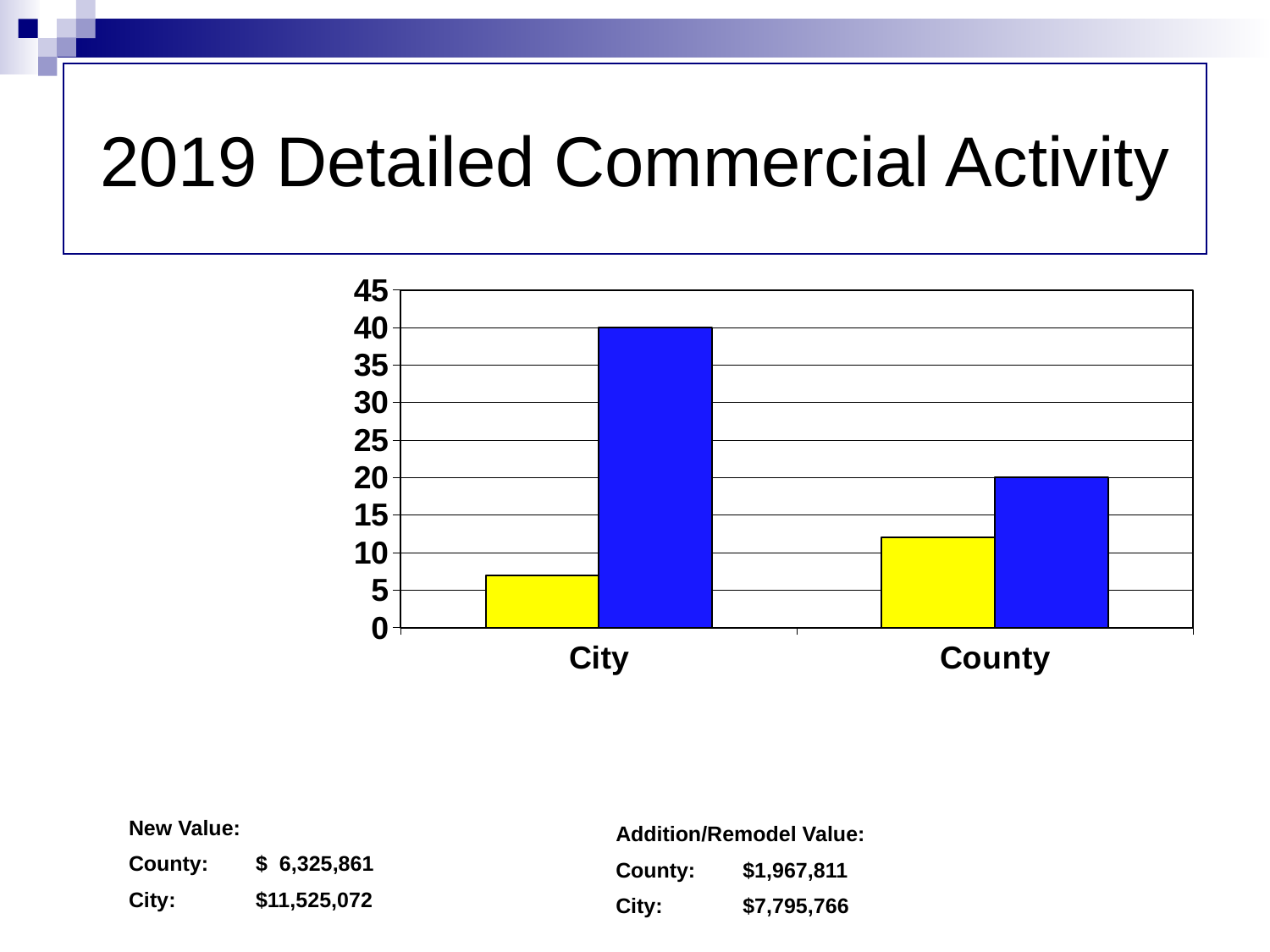
What is the difference between the blue bar for City and the blue bar for County? 20 Is the yellow bar for County greater or less than 10? greater Which bar in the chart is the shortest? the yellow bar for City What kind of chart is shown on the slide? bar chart Which bar in the chart is the tallest? the blue bar for City Which is larger, the yellow bar for City or the yellow bar for County? the yellow bar for County Is the yellow bar for City greater or less than 10? less What is the value of the blue bar for City? 40 What is the highest value shown on the y axis of the chart? 45 What is the value of the blue bar for County? 20 Is the yellow bar for County greater or less than 15? less How many categories are shown on the x axis of the chart? 2